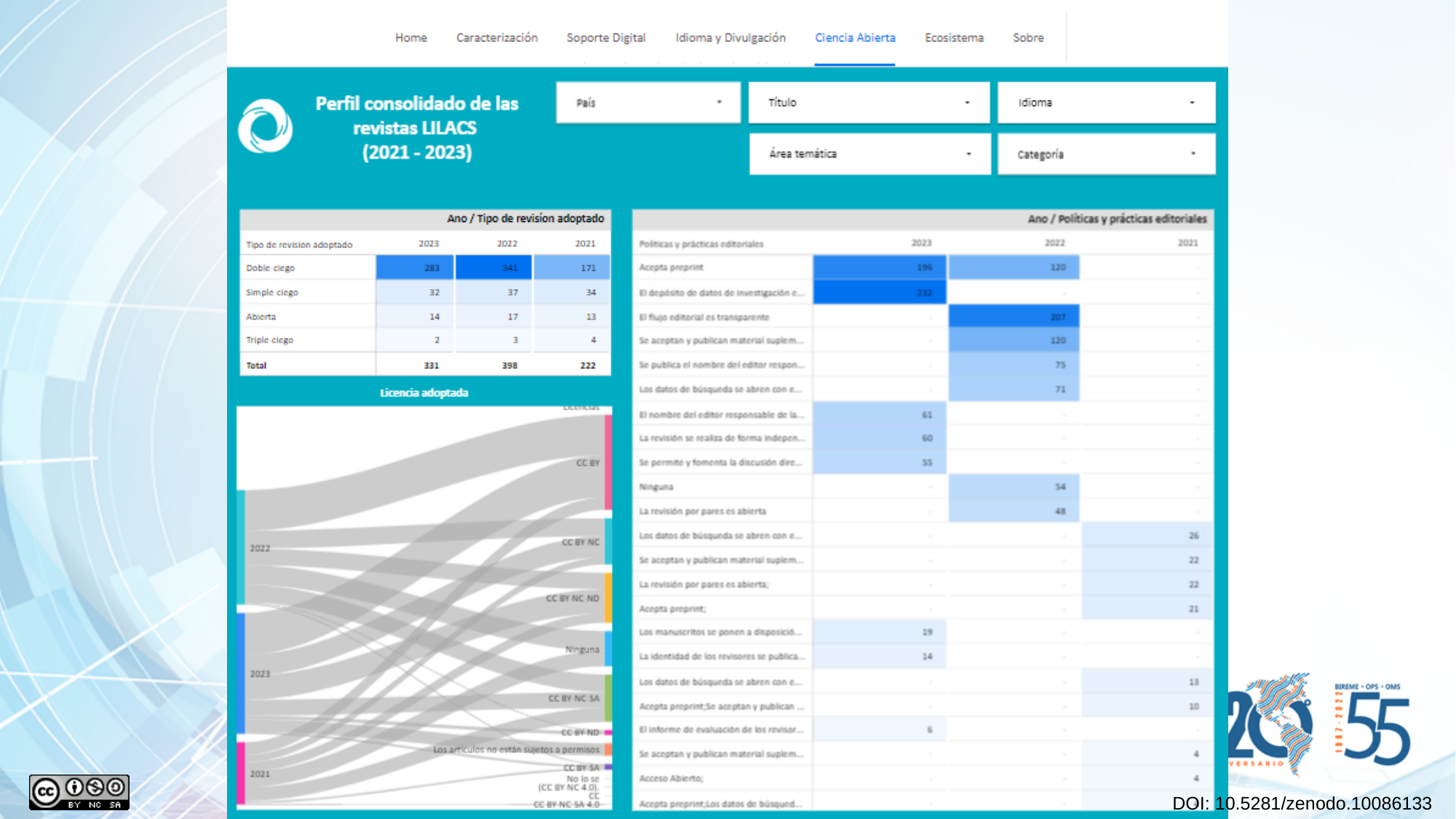
In the 'Ano / Políticas y prácticas editoriales' table, what is the value for 'El flujo editorial es transparente' in 2022? 207 What kind of chart is the 'Licencia adoptada' visualization at the bottom left of the slide? Sankey diagram In the 'Ano / Tipo de revisión adoptado' table, what is the value for Doble ciego in 2022? 341 In the 'Ano / Políticas y prácticas editoriales' table, what is the value for 'Acepta preprint' in 2023? 196 In the 'Ano / Tipo de revisión adoptado' table, what is the difference between the Total for 2022 and the Total for 2021? 176 In the 'Ano / Políticas y prácticas editoriales' table, what is the value for 'Ninguna' in 2022? 54 How many types of review (excluding Total) are listed in the 'Ano / Tipo de revisión adoptado' table? 4 In the 'Ano / Tipo de revisión adoptado' table, which is larger: Simple ciego in 2022 or Simple ciego in 2021? Simple ciego in 2022 In the 'Ano / Tipo de revisión adoptado' table, what is the Total for 2023? 331 In the 'Ano / Tipo de revisión adoptado' table, which type of review has the highest value in 2021? Doble ciego In the 'Ano / Tipo de revisión adoptado' table, which type of review has the lowest value in 2023? Triple ciego In the 'Ano / Políticas y prácticas editoriales' table, what is the difference between 'Acepta preprint' in 2023 and in 2022? 76